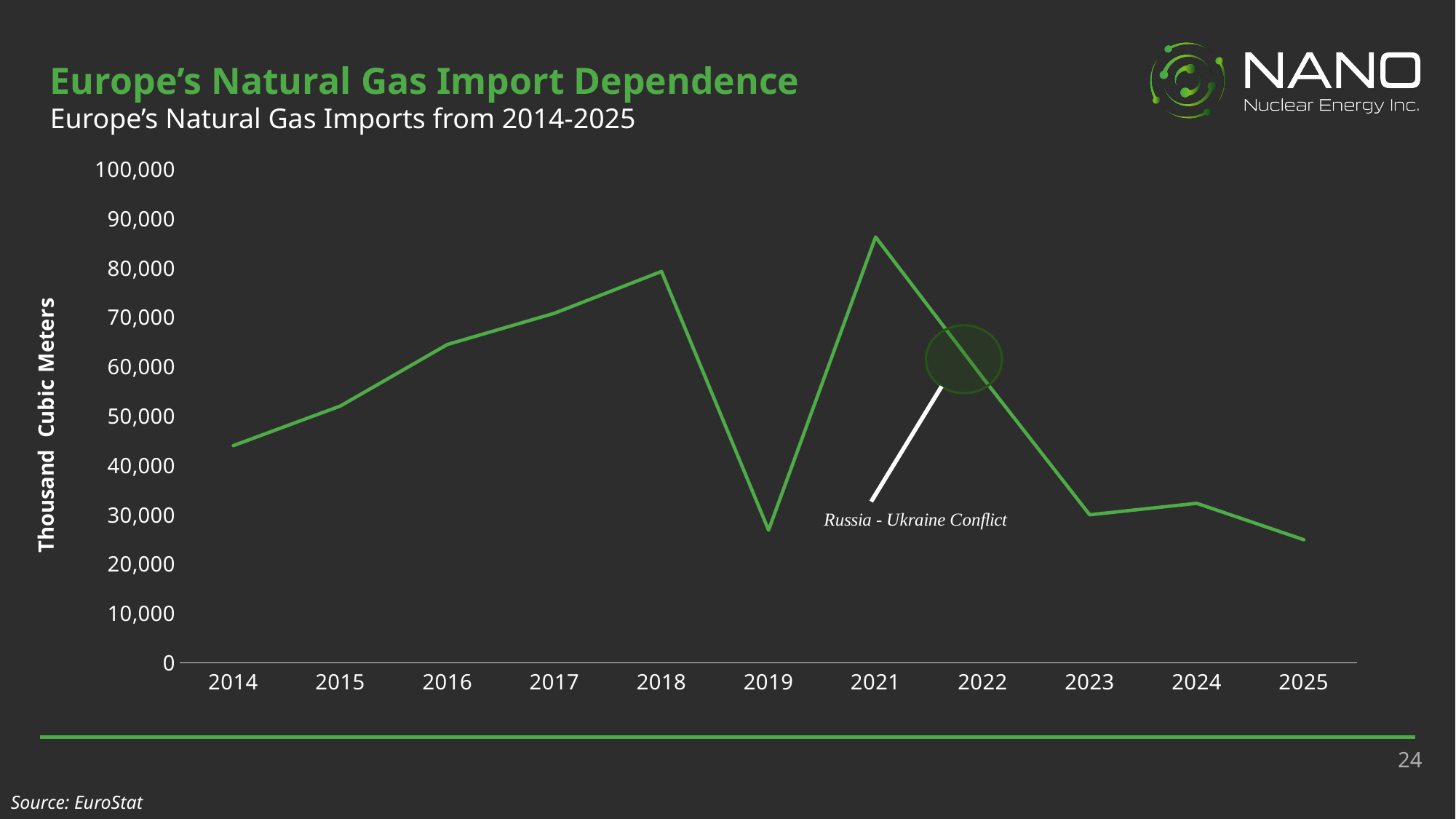
Which year has the larger value, 2018 or 2019? 2018 Do the values rise or fall from 2014 to 2018? rise How many years are plotted along the x axis of the chart? 11 Is the value for 2021 greater or less than 80,000? greater Is the value for 2014 greater or less than 40,000? greater Is the value for 2019 greater or less than 30,000? less What kind of chart is shown on the slide? line chart What is the label on the y axis of the chart? Thousand Cubic Meters Which year has the highest value on the chart? 2021 Do the values rise or fall from 2021 to 2023? fall